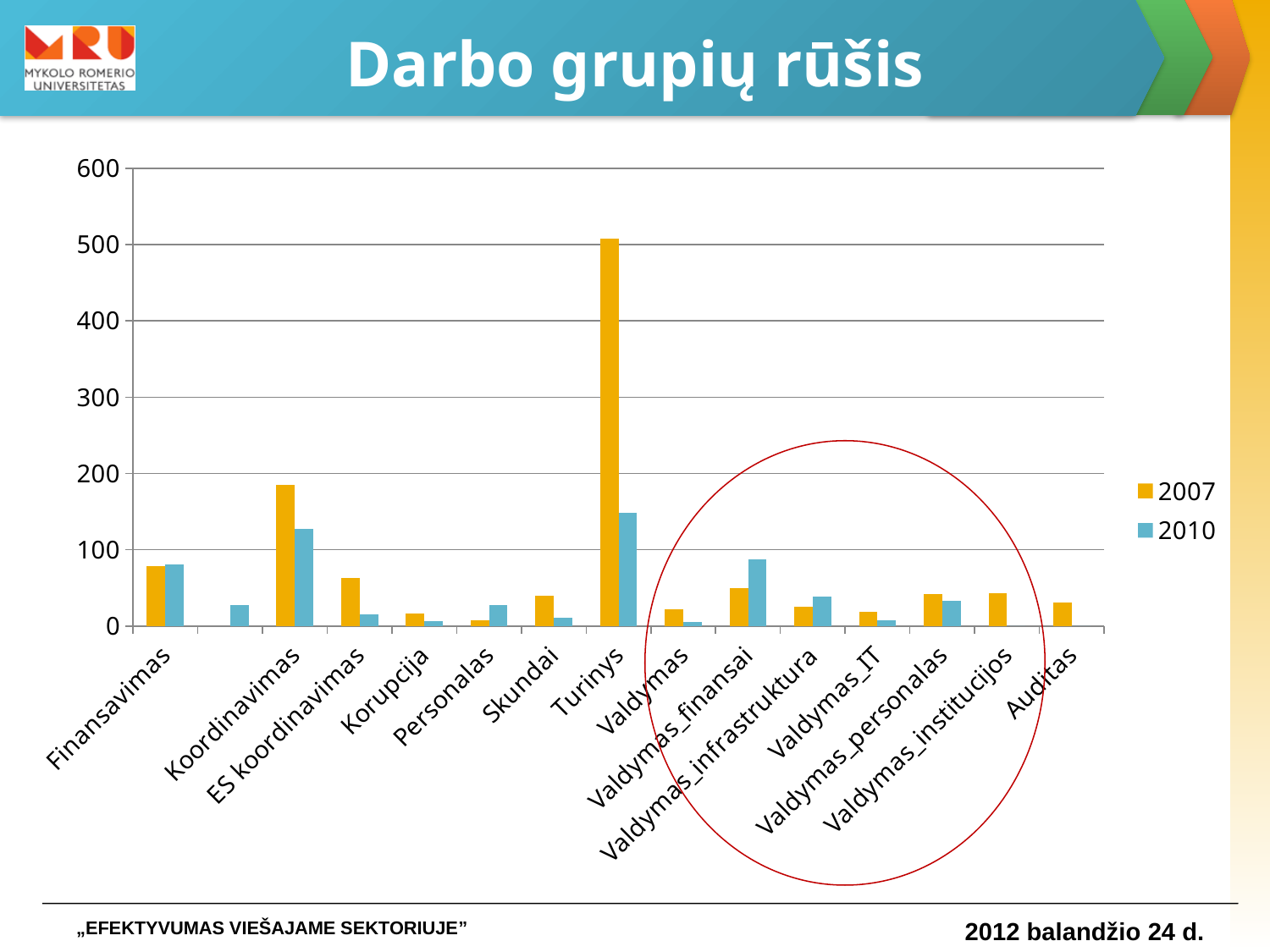
For Valdymas_finansai, which series has the larger value, 2007 or 2010? 2010 Which category has the highest value for 2007? Turinys How many series does the legend list? 2 What is the title of the chart? Darbo grupių rūšis Which years are listed in the legend? 2007 and 2010 Which category has the highest value for 2010? Turinys What kind of chart is shown on the slide? bar chart Is the 2007 value for Koordinavimas greater or less than 100? greater Is the 2007 value for Finansavimas greater or less than 100? less For Koordinavimas, which series has the larger value, 2007 or 2010? 2007 Is the 2010 value for Turinys greater or less than 100? greater